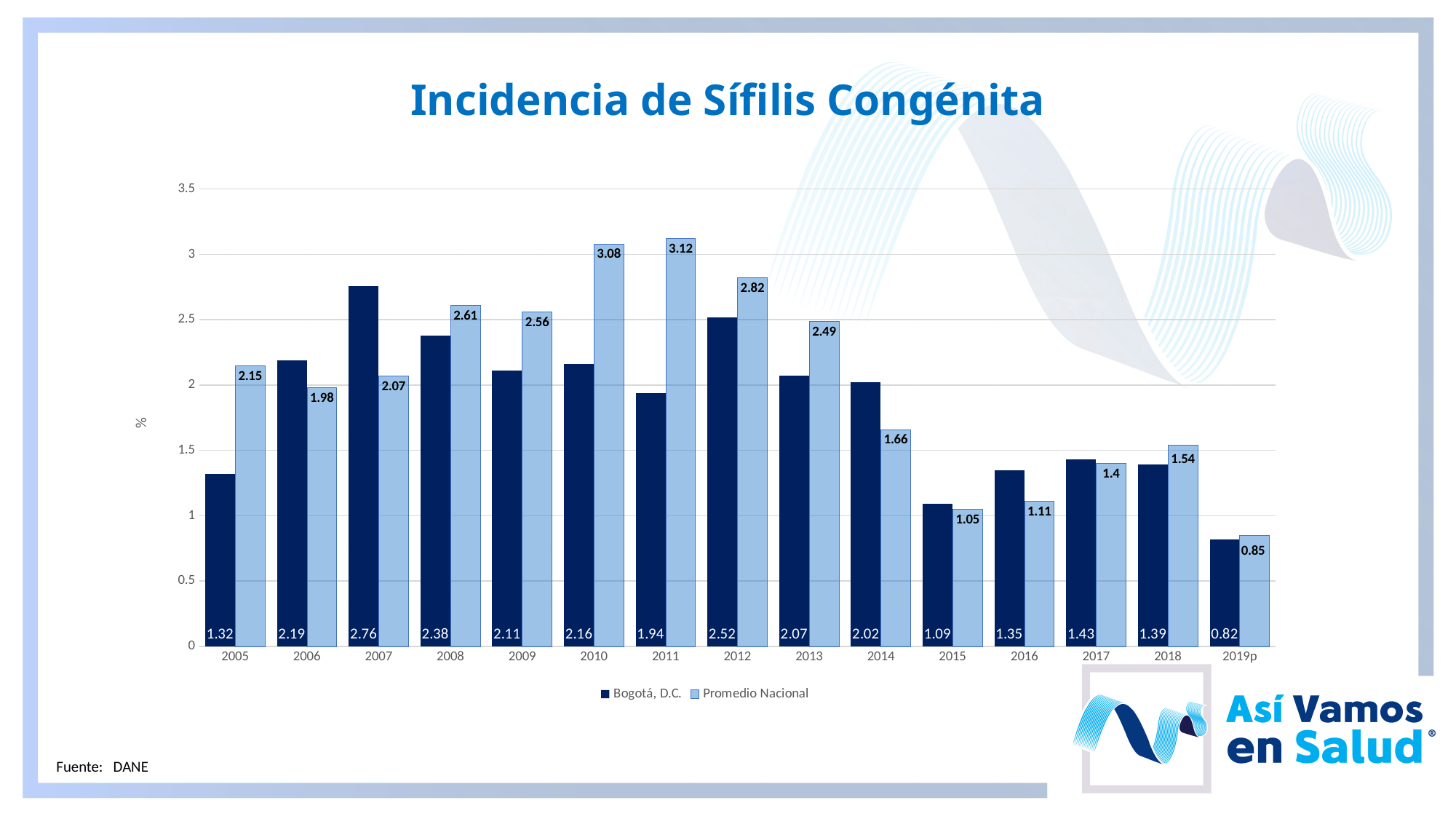
Is the Promedio Nacional value for 2010 greater or less than 3? greater How many years are shown on the x axis? 15 In 2006, which is larger: Bogotá, D.C. or Promedio Nacional? Bogotá, D.C. What is the difference between the Promedio Nacional and Bogotá, D.C. values in 2011? 1.18 How many series does the legend list? 2 In which year is the Bogotá, D.C. value lowest? 2019p What is the value for Bogotá, D.C. in 2007? 2.76 In which year is the Promedio Nacional value highest? 2011 What kind of chart is shown on the slide? bar chart What is the value for Bogotá, D.C. in 2019p? 0.82 What is the Promedio Nacional value in 2011? 3.12 Does the Promedio Nacional value rise or fall from 2011 to 2019p? fall